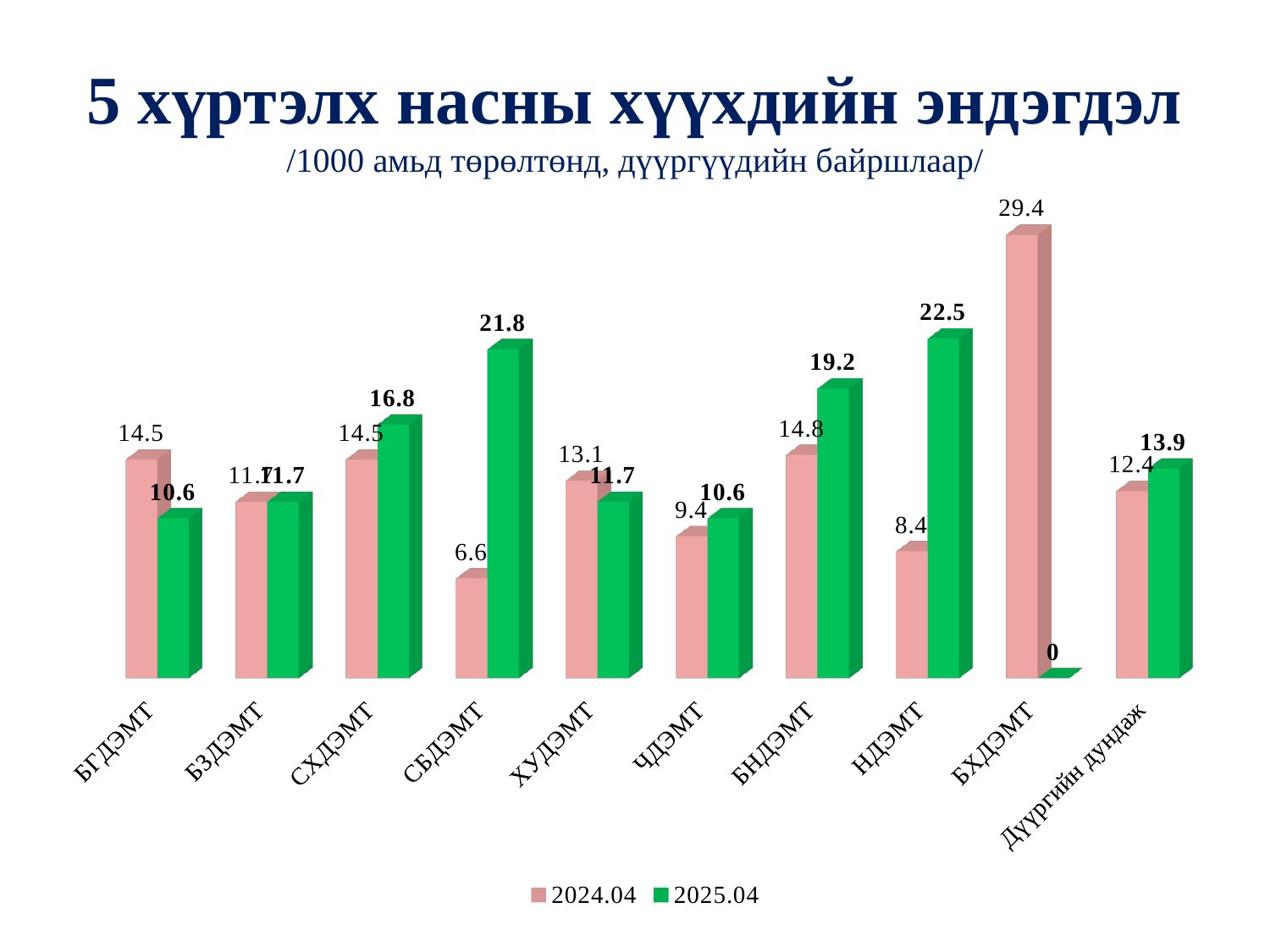
Which series is shown in green in the legend? 2025.04 Which category has the lowest 2024.04 value? СБДЭМТ How many categories are shown on the x axis? 10 What is the 2024.04 value for БХДЭМТ? 29.4 What kind of chart is shown on the slide? Bar chart What is the 2024.04 value for НДЭМТ? 8.4 What is the 2025.04 value for СБДЭМТ? 21.8 What is the difference between the 2025.04 and 2024.04 values for НДЭМТ? 14.1 What is the 2025.04 value for Дүүргийн дундаж? 13.9 Which is larger for ХУДЭМТ, the 2024.04 value or the 2025.04 value? 2024.04 How many series does the legend list? 2 Which category has the highest 2025.04 value? НДЭМТ